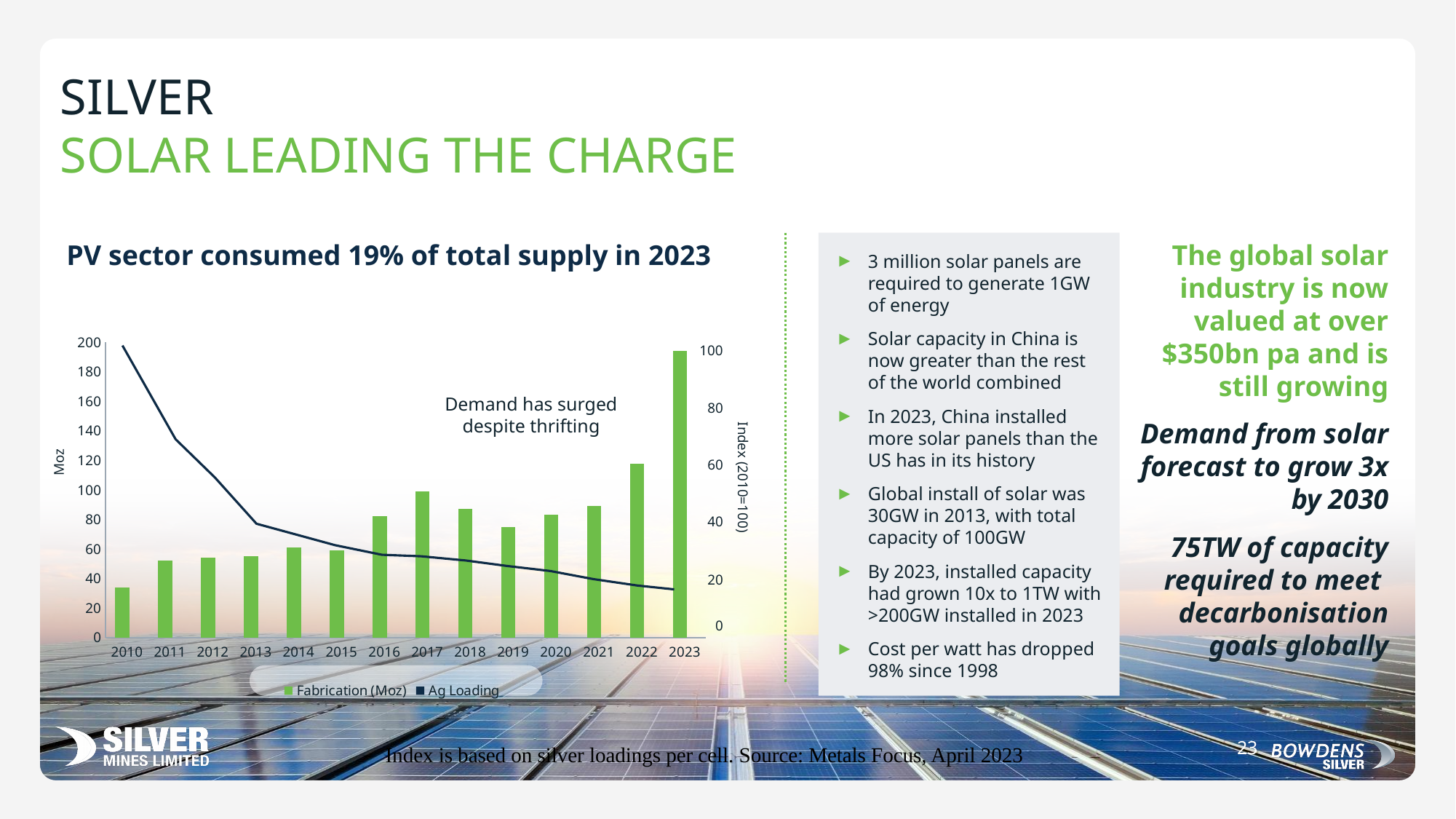
Is the Fabrication (Moz) value for 2010 greater or less than 40? less Which year has the lowest Fabrication (Moz) bar? 2010 Does the Ag Loading line rise or fall from 2010 to 2023? It falls Which year has a larger Fabrication (Moz) bar, 2017 or 2019? 2017 What are the two entries in the chart legend? Fabrication (Moz) and Ag Loading Which year has the highest Fabrication (Moz) bar? 2023 Is the Fabrication (Moz) value for 2022 greater or less than 100? greater What kind of chart is shown on the slide? A bar chart combined with a line chart How many years are shown on the x axis of the chart? 14 Is the Fabrication (Moz) value for 2023 greater or less than 160? greater How many series does the chart legend list? 2